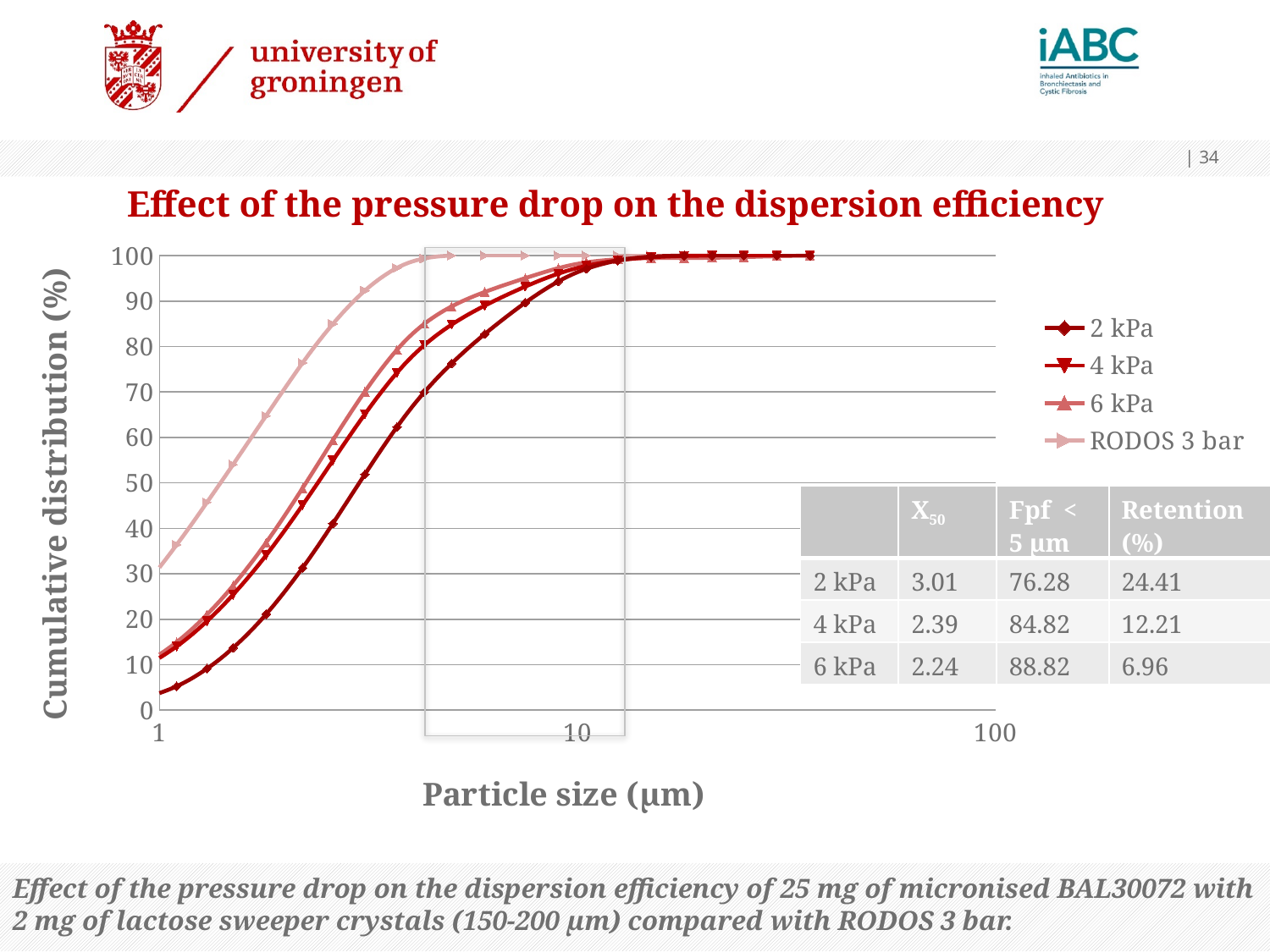
Do the values of the 2 kPa series rise or fall as particle size increases along the x axis? Rise At a particle size of 1 µm, is the value for the RODOS 3 bar series greater or less than 20? greater At a particle size of 10 µm, is the value for the 2 kPa series greater or less than 90? greater What is the title of the chart? Effect of the pressure drop on the dispersion efficiency Which series has the lowest cumulative distribution at a particle size of 1 µm? 2 kPa At a particle size of 1 µm, is the value for the 2 kPa series greater or less than 10? less How many series does the chart legend list? 4 At a particle size of 1 µm, which series has a higher value, RODOS 3 bar or 2 kPa? RODOS 3 bar What kind of chart is shown on the slide? Line chart Which series reaches 100% cumulative distribution at the smallest particle size? RODOS 3 bar What is the label of the y axis of the chart? Cumulative distribution (%)